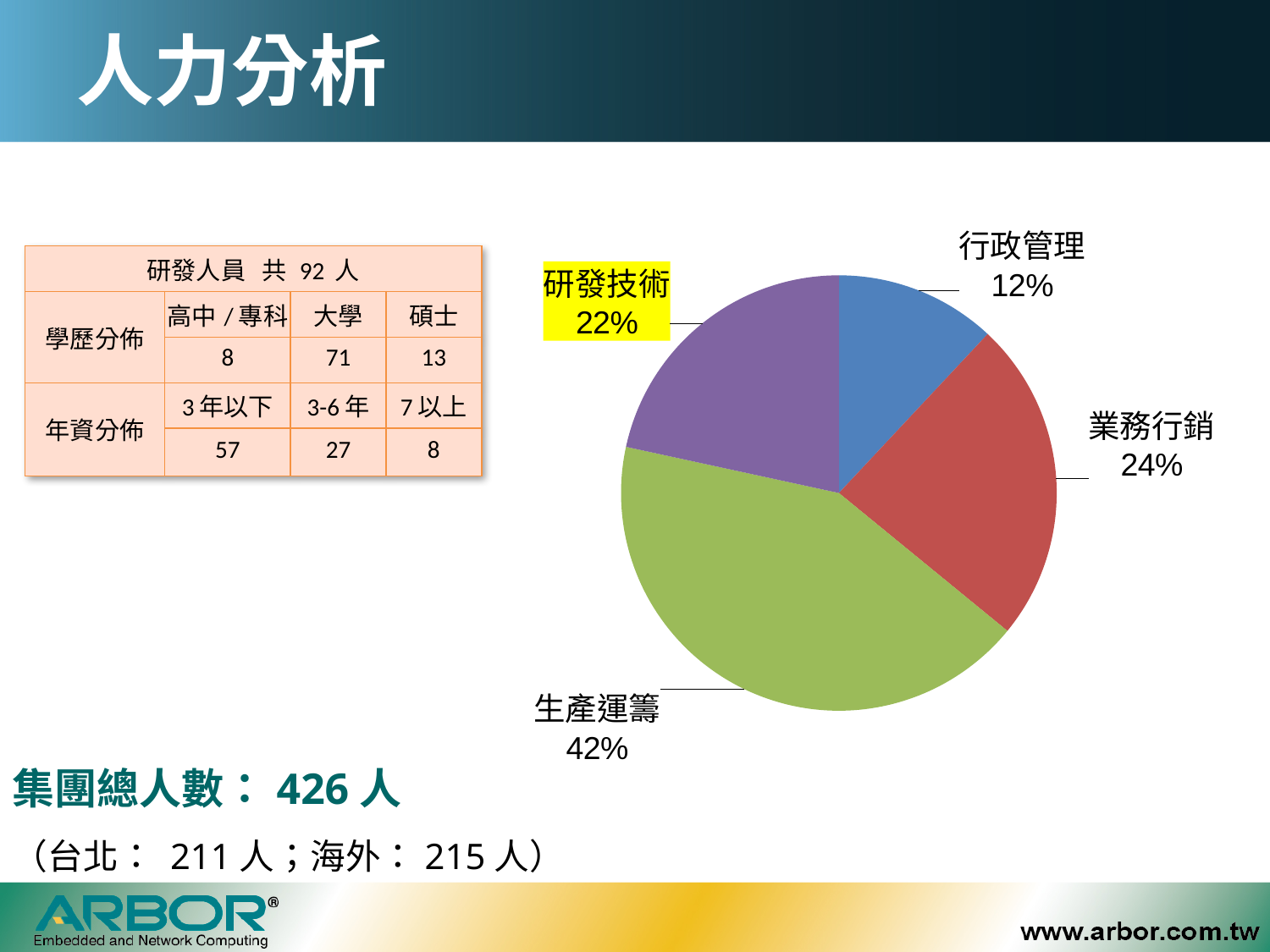
What share of the pie does 生產運籌 represent? 42% How many slices does the pie chart have? 4 Which category has the smallest slice of the pie chart? 行政管理 What is the difference in percentage points between 生產運籌 and 研發技術? 20 Which slice label in the pie chart is highlighted in yellow? 研發技術 Which category has the largest slice of the pie chart? 生產運籌 What share of the pie does 行政管理 represent? 12% What kind of chart is shown on the slide? pie chart Which is larger, the share for 業務行銷 or the share for 研發技術? 業務行銷 What share of the pie does 研發技術 represent? 22% What is the difference in percentage points between 業務行銷 and 行政管理? 12